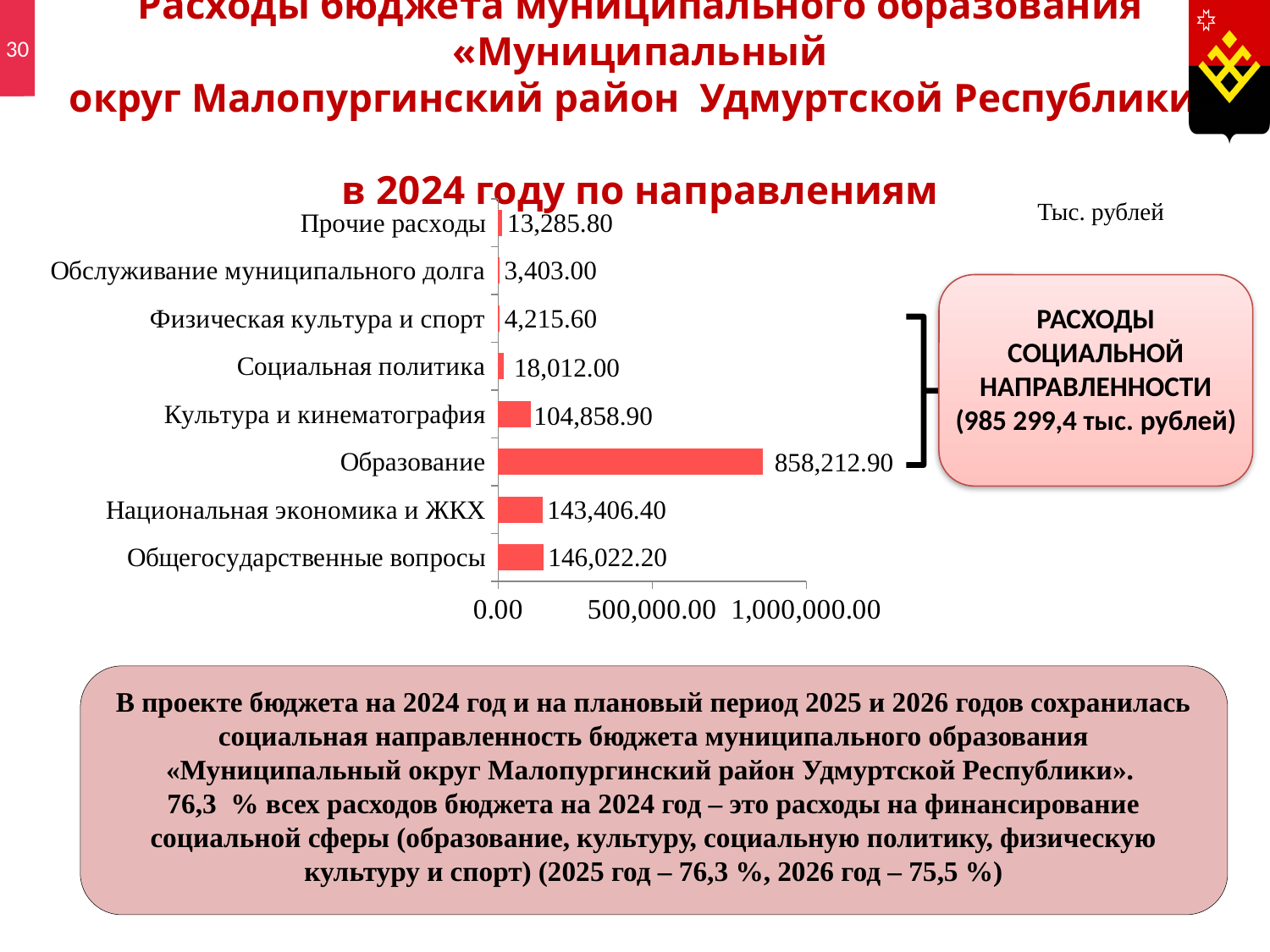
What kind of chart is shown on the slide? bar chart What is the value for Национальная экономика и ЖКХ? 143,406.40 What is the value for Образование? 858,212.90 What is the difference between Социальная политика and Физическая культура и спорт? 13,796.40 What is the value for Обслуживание муниципального долга? 3,403.00 What is the difference between Общегосударственные вопросы and Национальная экономика и ЖКХ? 2,615.80 Which category has the highest value? Образование What is the value for Культура и кинематография? 104,858.90 Which is larger, Культура и кинематография or Социальная политика? Культура и кинематография How many categories are shown in the chart? 8 Which category has the lowest value? Обслуживание муниципального долга Is the value for Образование greater or less than 500,000.00? greater